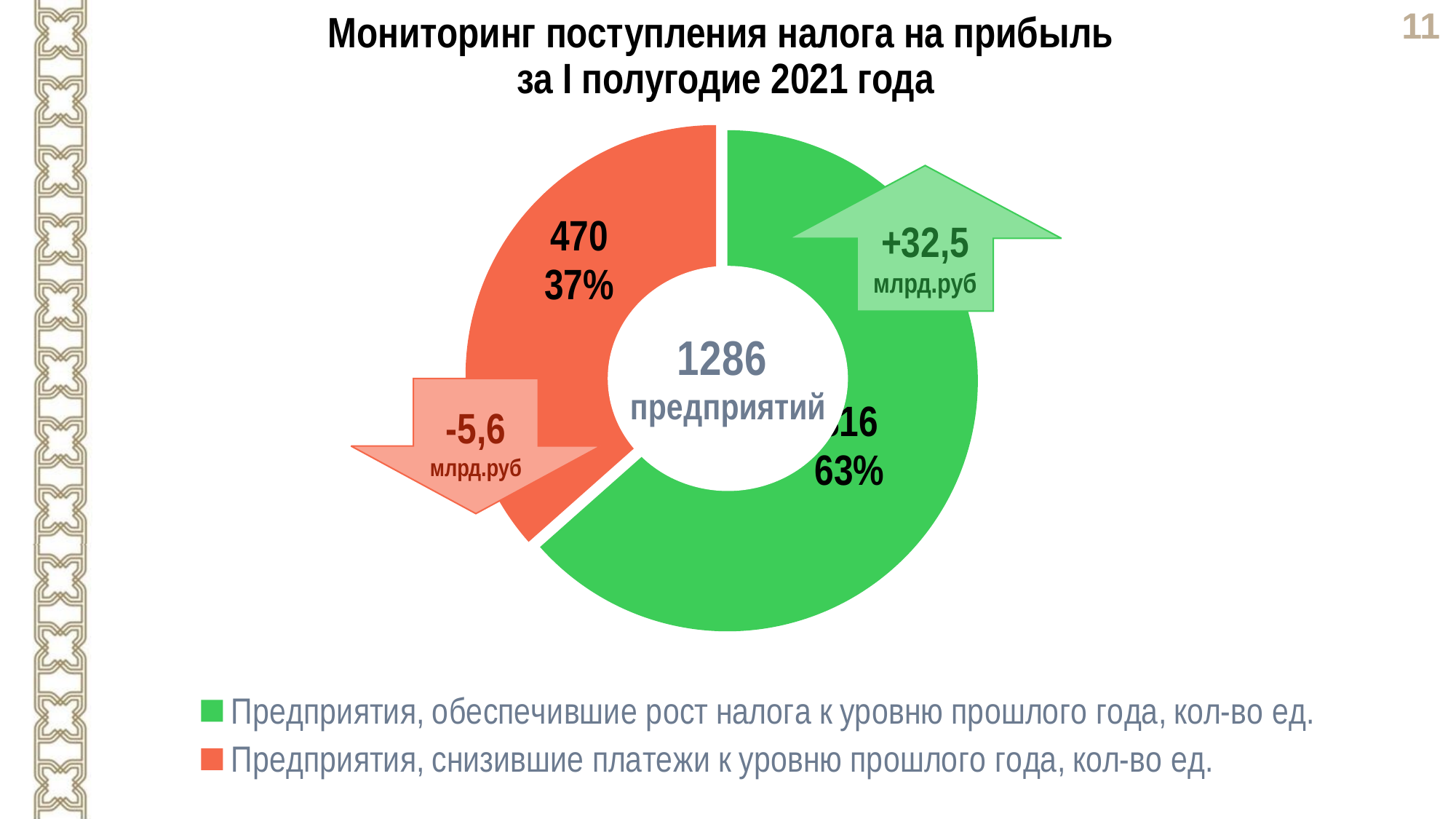
What is the number of enterprises that reduced payments compared to last year (Предприятия, снизившие платежи к уровню прошлого года)? 470 How many entries does the legend list? 2 What share of the doughnut is taken by enterprises that reduced payments compared to last year? 37% What is the total number of enterprises shown in the centre of the doughnut chart? 1286 предприятий What is the title of the chart on the slide? Мониторинг поступления налога на прибыль за I полугодие 2021 года Which category has the smaller slice in the doughnut chart? Предприятия, снизившие платежи к уровню прошлого года How many slices does the doughnut chart have? 2 Which category has the larger slice: enterprises that ensured tax growth or enterprises that reduced payments? Предприятия, обеспечившие рост налога к уровню прошлого года What kind of chart is shown on the slide? doughnut (pie) chart Which colour represents enterprises that reduced payments compared to last year? red (orange-red) By how many percentage points does the share of enterprises with tax growth exceed the share of enterprises that reduced payments? 26 What share of the doughnut is taken by enterprises that ensured tax growth compared to last year? 63%